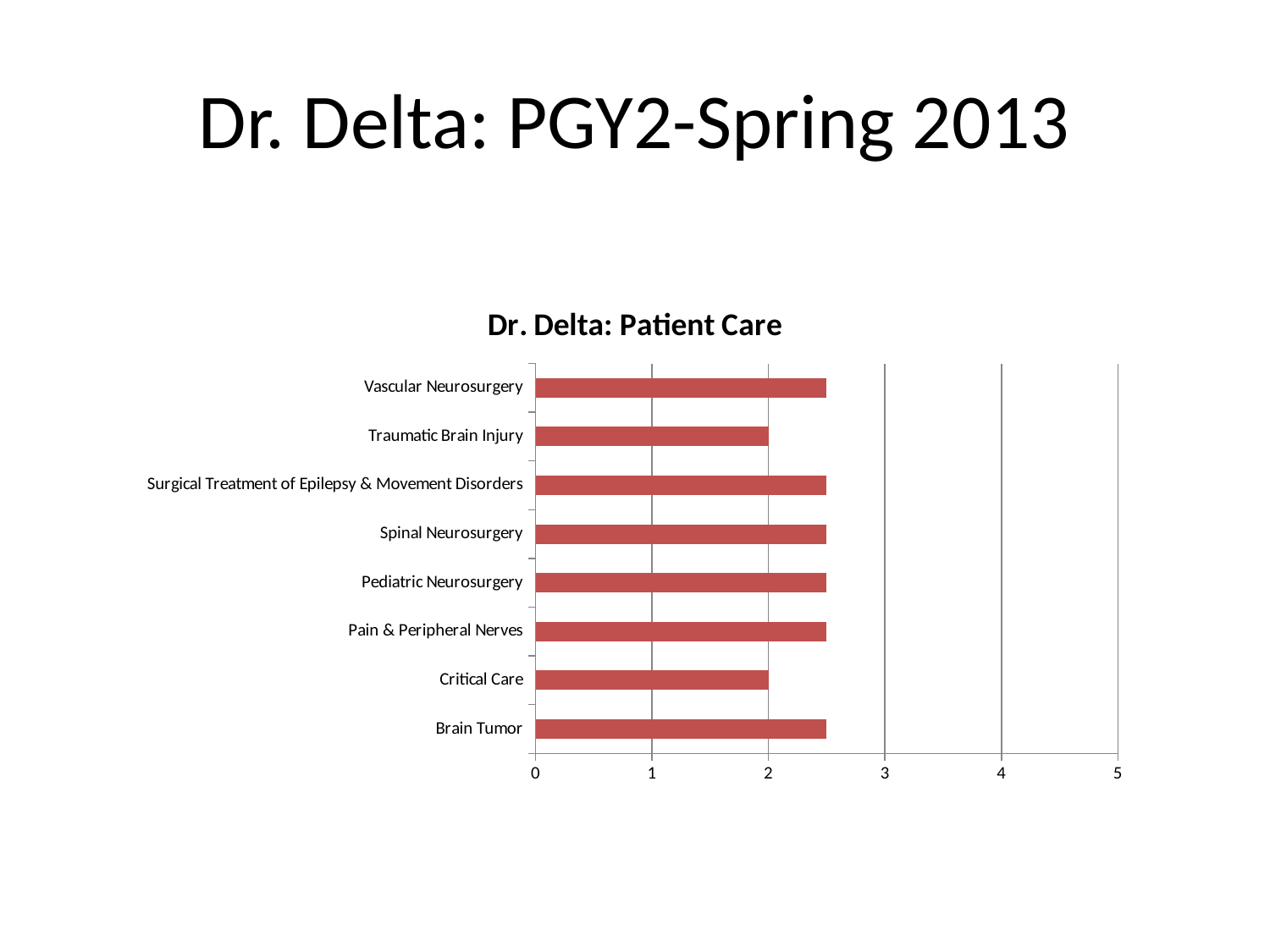
Is the value for Spinal Neurosurgery greater or less than 2? greater How many categories are plotted in the chart? 8 What type of chart is shown on the slide? bar chart What is the value for Critical Care? 2 Which is larger, the value for Critical Care or the value for Pediatric Neurosurgery? Pediatric Neurosurgery What is the value for Traumatic Brain Injury? 2 What is the maximum value shown on the horizontal axis? 5 What is the title of the chart? Dr. Delta: Patient Care Is the value for Pain & Peripheral Nerves greater or less than 3? less Which is larger, the value for Vascular Neurosurgery or the value for Traumatic Brain Injury? Vascular Neurosurgery Is the value for Brain Tumor greater or less than 3? less